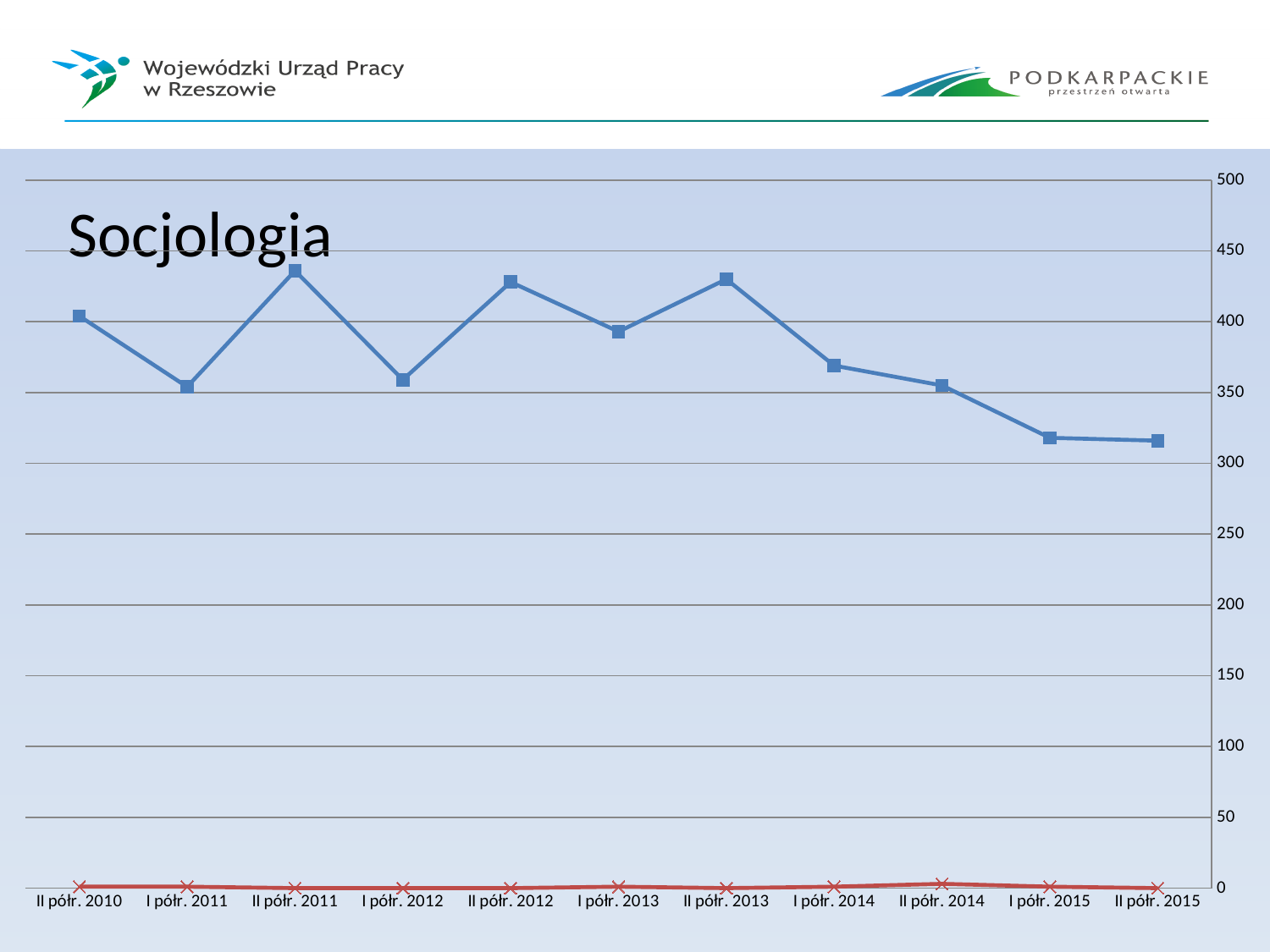
Is the value of the blue series for I półr. 2011 greater or less than 400? less How many periods are shown on the x axis of the chart? 11 What is the title of the chart? Socjologia What kind of chart is shown on the slide? line chart Which has the higher value in the blue series: II półr. 2012 or I półr. 2015? II półr. 2012 Is the value of the blue series for II półr. 2011 greater or less than 400? greater Does the blue series rise or fall from II półr. 2013 to II półr. 2015? fall Is the value of the blue series for II półr. 2013 greater or less than 400? greater Which has the higher value in the blue series: II półr. 2010 or I półr. 2011? II półr. 2010 How many data series (lines) are plotted on the chart? 2